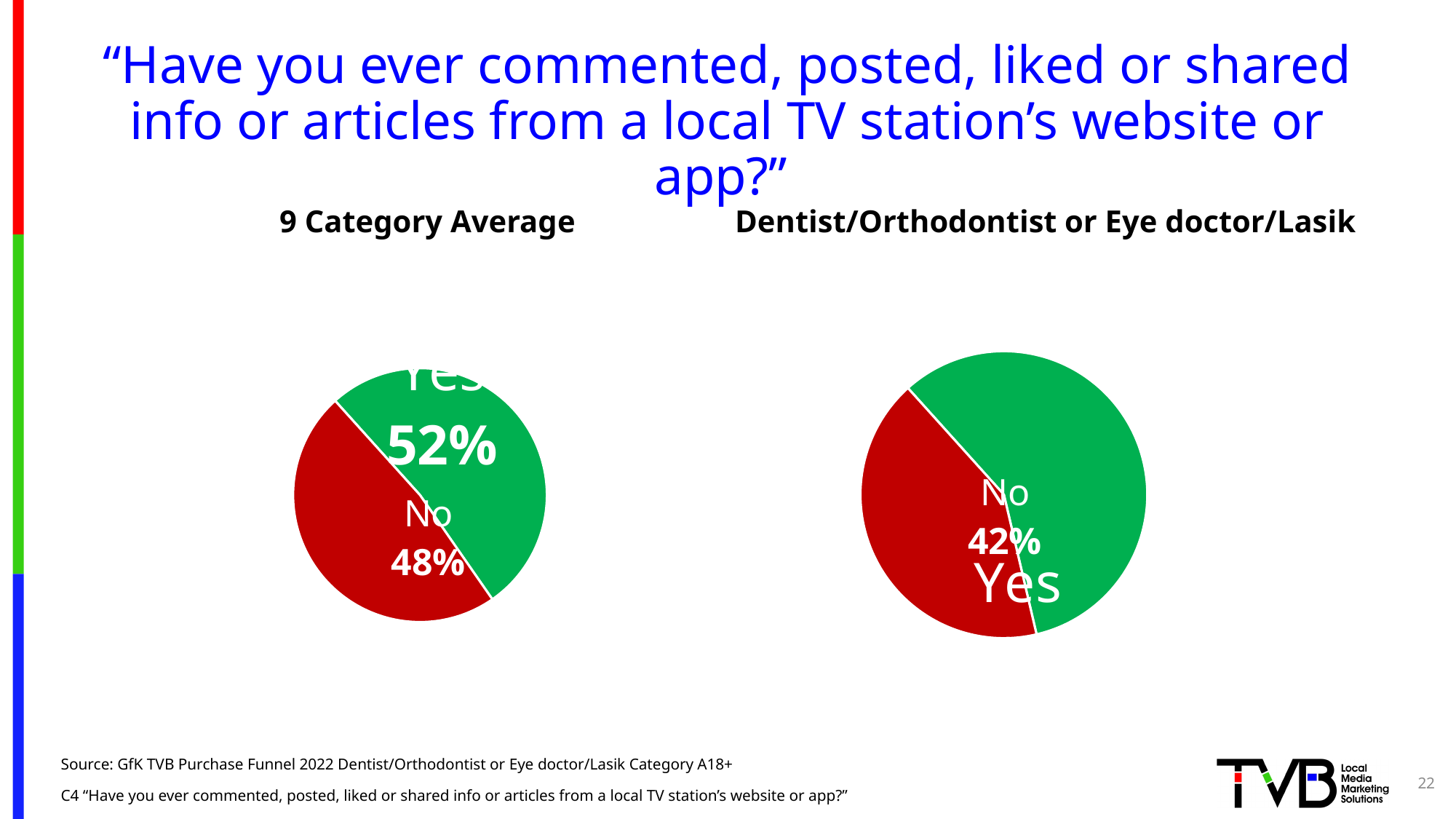
What kind of chart is used on this slide? Pie chart In the 9 Category Average chart, which response has the larger share, Yes or No? Yes What is the title of the pie chart on the right? Dentist/Orthodontist or Eye doctor/Lasik In the 9 Category Average chart, which response has the smallest share? No In the 9 Category Average chart, what is the difference in percentage points between Yes and No? 4 In the 9 Category Average chart, what percentage answered Yes? 52% In the Dentist/Orthodontist or Eye doctor/Lasik chart, which response has the larger share, Yes or No? Yes In the Dentist/Orthodontist or Eye doctor/Lasik chart, what percentage answered No? 42% How many pie charts are shown on the slide? 2 In the 9 Category Average chart, what percentage answered No? 48% What colour represents the No slice in both pie charts? Red How many slices does the 9 Category Average pie chart have? 2